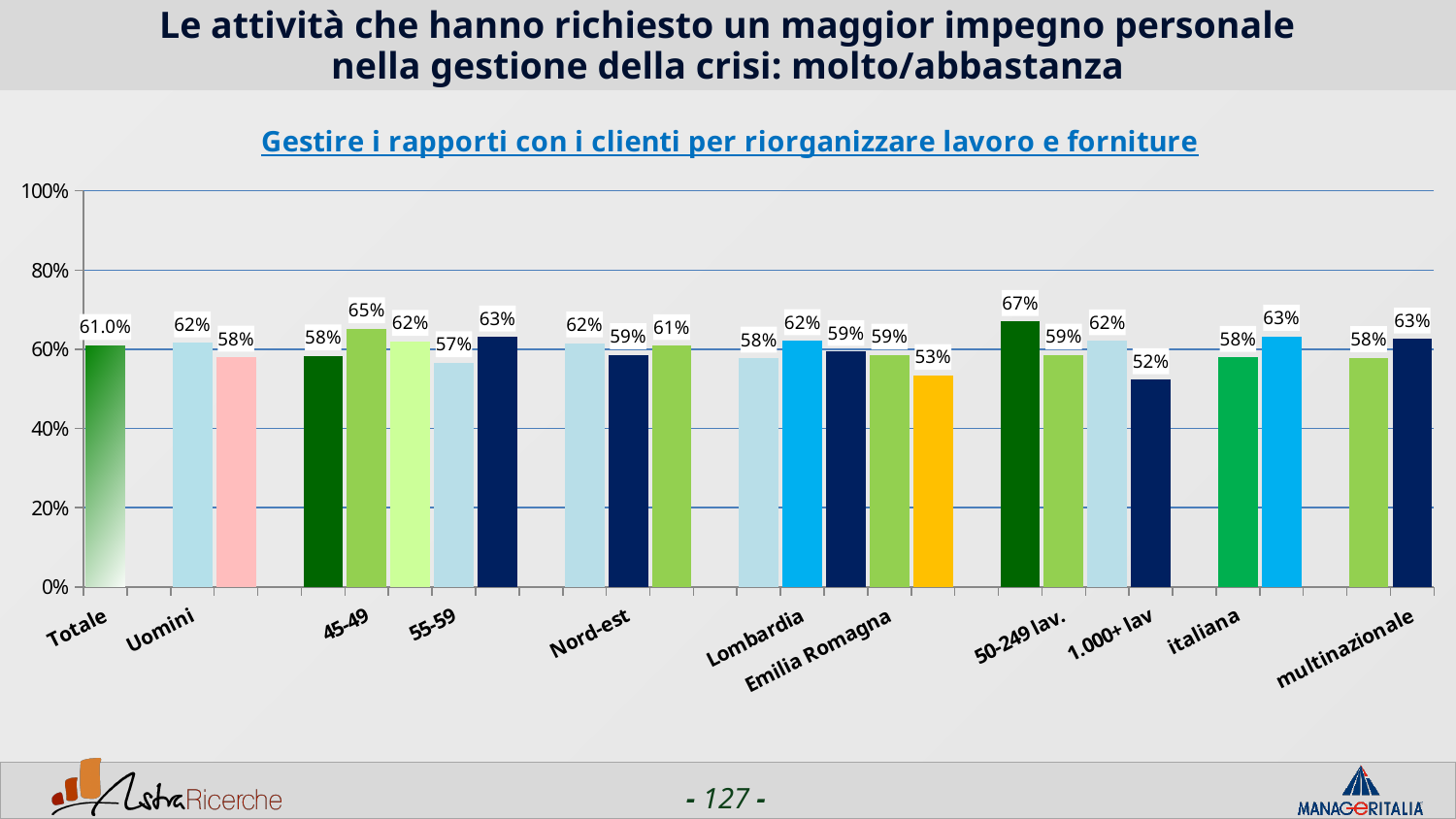
What is the value for 1.000+ lav? 52% What is the value for the 45-49 age group? 65% Is the value for Totale greater or less than 60%? greater Which is larger, the value for Lombardia or the value for Emilia Romagna? Lombardia Which labelled category has the lowest value in the chart? 1.000+ lav What is the difference between the values for 45-49 and 55-59? 8 percentage points What kind of chart is shown on the slide? Bar chart What is the value for Uomini? 62% What is the value for multinazionale? 63% What is the value for Totale? 61.0% What is the value for the 55-59 age group? 57% What is the title of the chart (the underlined subtitle above it)? Gestire i rapporti con i clienti per riorganizzare lavoro e forniture